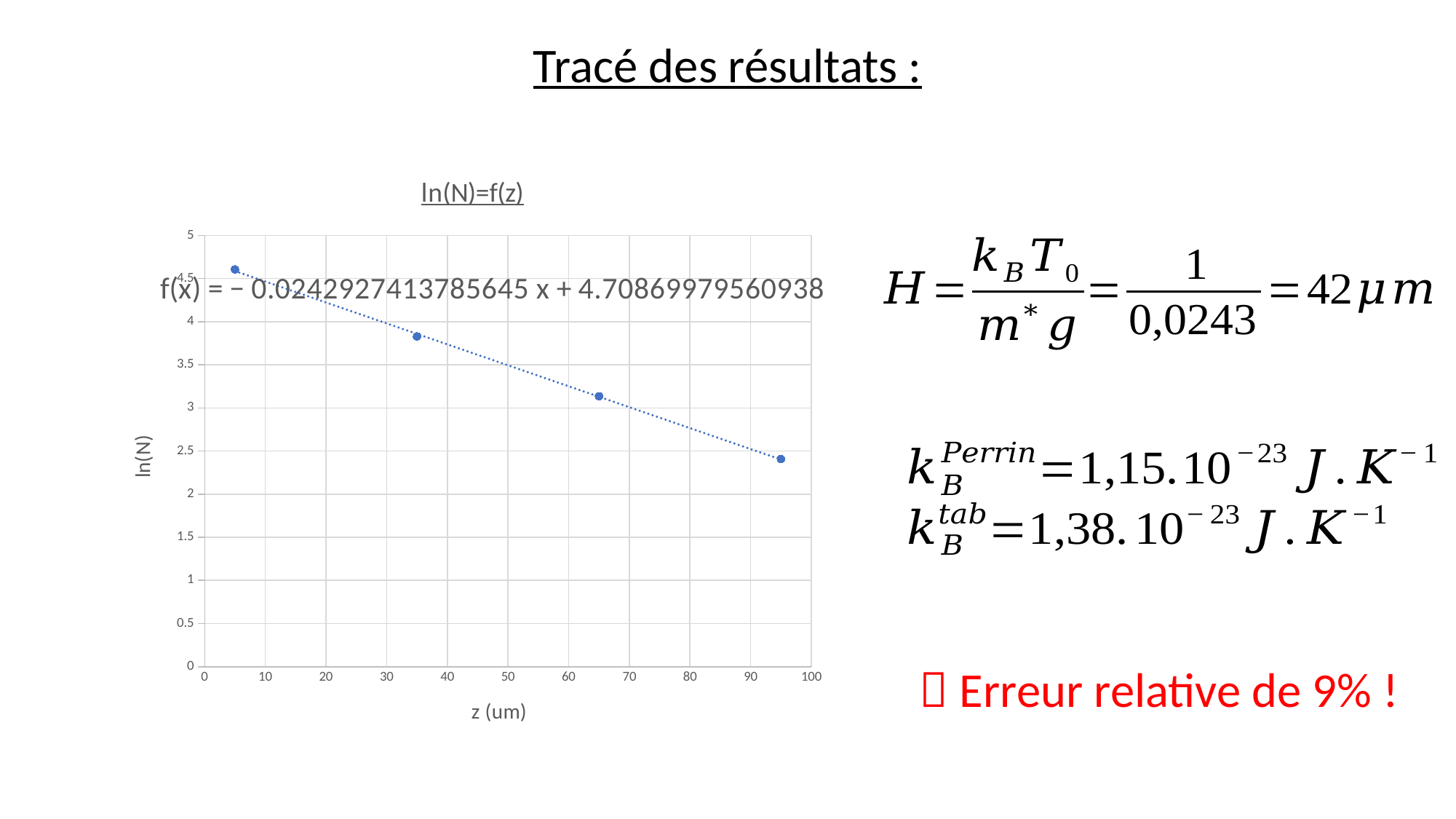
How many data points are plotted on the chart? 4 Is the ln(N) value of the data point near z = 65 greater or less than 3.5? less What is the slope of the trendline equation shown on the chart? -0.0242927413785645 Which data point has the highest ln(N) value, the leftmost or the rightmost? the leftmost What kind of chart is shown on the slide? scatter chart Is the ln(N) value of the leftmost data point greater or less than 4? greater Is the ln(N) value of the data point near z = 35 greater or less than 3.5? greater Do the ln(N) values rise or fall as z increases along the x axis? fall What is the title of the chart? ln(N)=f(z) What is the label of the x axis of the chart? z (um) What is the intercept of the trendline equation shown on the chart? 4.70869979560938